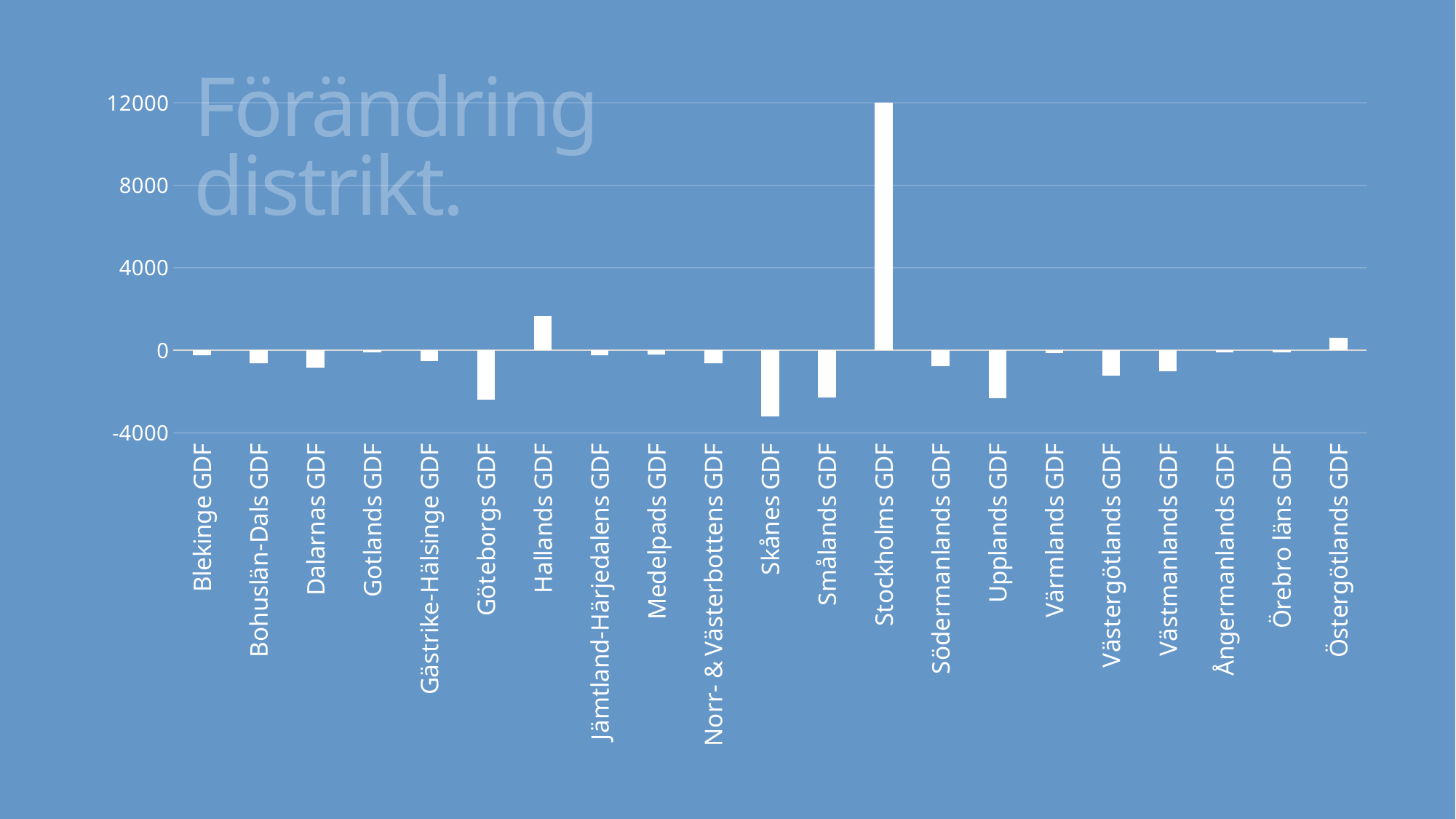
Is the value for Skånes GDF greater or less than -4000? greater Is the value for Skånes GDF greater or less than 0? less Which district has the highest value? Stockholms GDF Is the value for Göteborgs GDF greater or less than 0? less What kind of chart is shown on the slide? Bar chart How many districts (categories) are shown on the x axis? 21 Which district has the lowest value? Skånes GDF Which has the larger value, Hallands GDF or Östergötlands GDF? Hallands GDF What is the title of the chart? Förändring distrikt. Which has the larger value, Stockholms GDF or Hallands GDF? Stockholms GDF